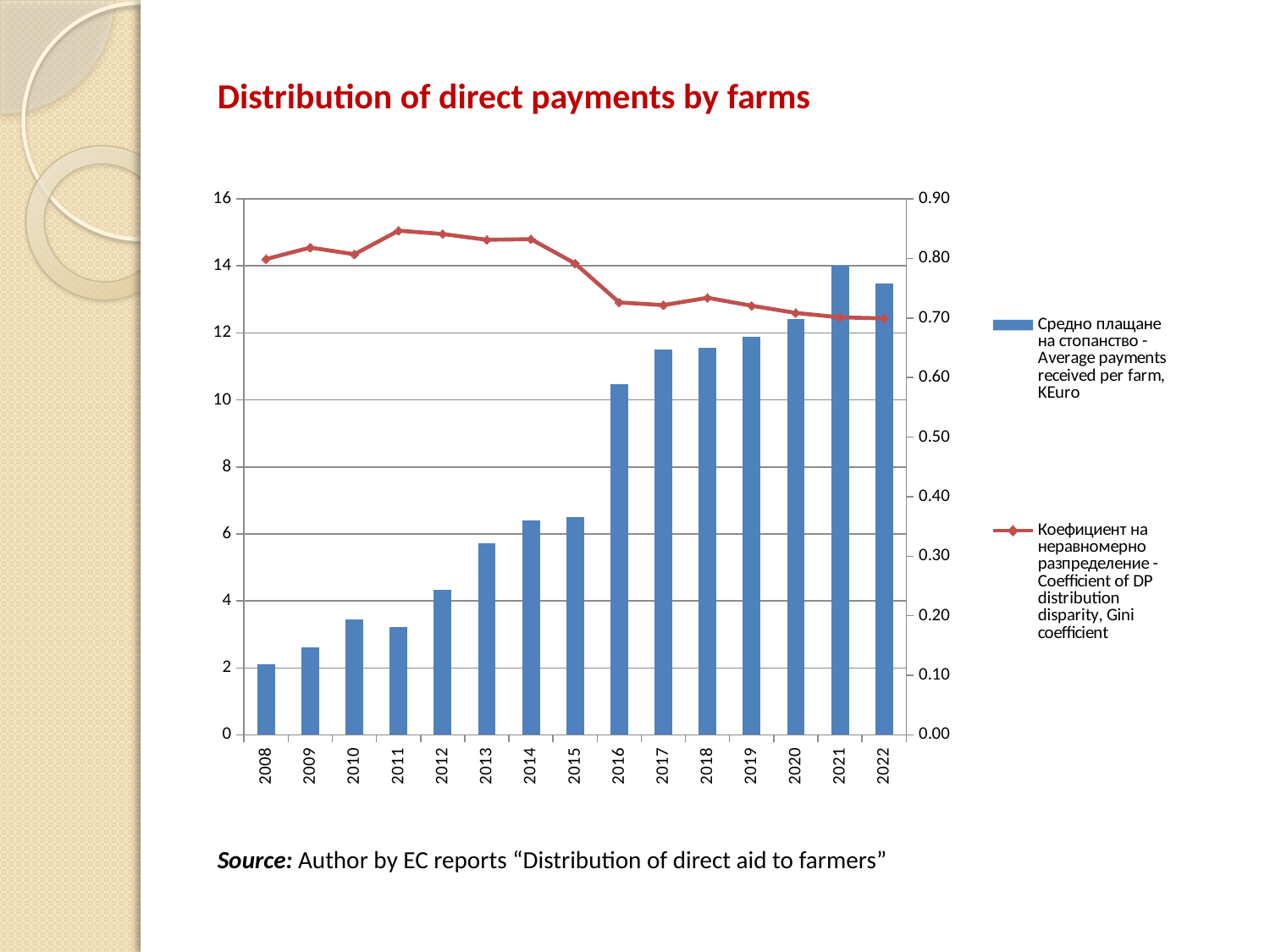
Which year has the larger average payment per farm, 2015 or 2016? 2016 Does the Gini coefficient line generally rise or fall from 2008 to 2022? fall Which year has the lowest bar for average payments received per farm? 2008 How many years are shown on the x axis? 15 How many series does the legend list? 2 Is the Gini coefficient for 2022 greater or less than 0.80? less Is the average payment per farm for 2020 greater or less than 12 KEuro? greater Which year has the highest bar for average payments received per farm? 2021 Is the average payment per farm for 2016 greater or less than 10 KEuro? greater What kind of chart is shown on the slide? A combined bar and line chart